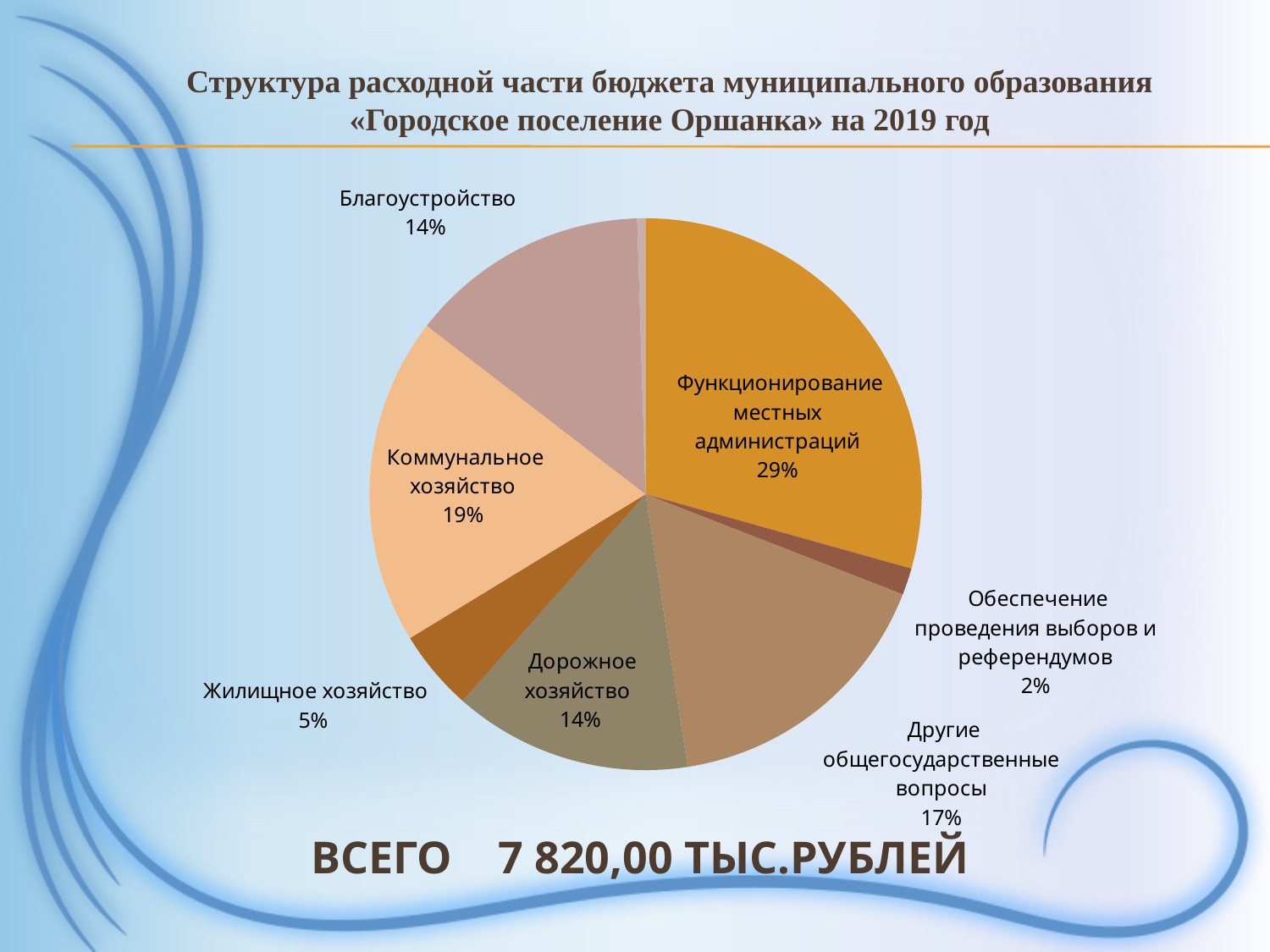
Which labeled category has the largest share of the pie? Функционирование местных администраций What kind of chart is shown on the slide? Pie chart What percentage is shown for «Обеспечение проведения выборов и референдумов»? 2% What percentage is shown for «Коммунальное хозяйство»? 19% Do «Благоустройство» and «Дорожное хозяйство» have the same percentage? Yes, 14% Which labeled category has the smallest share of the pie? Обеспечение проведения выборов и референдумов What is the difference in percentage points between «Функционирование местных администраций» and «Коммунальное хозяйство»? 10 What percentage is shown for «Другие общегосударственные вопросы»? 17% What share of the pie does «Функционирование местных администраций» have? 29% Which is larger: the share for «Другие общегосударственные вопросы» or for «Дорожное хозяйство»? Другие общегосударственные вопросы What percentage is shown for «Жилищное хозяйство»? 5% What total amount (ВСЕГО) is stated below the chart? 7 820,00 тыс.рублей